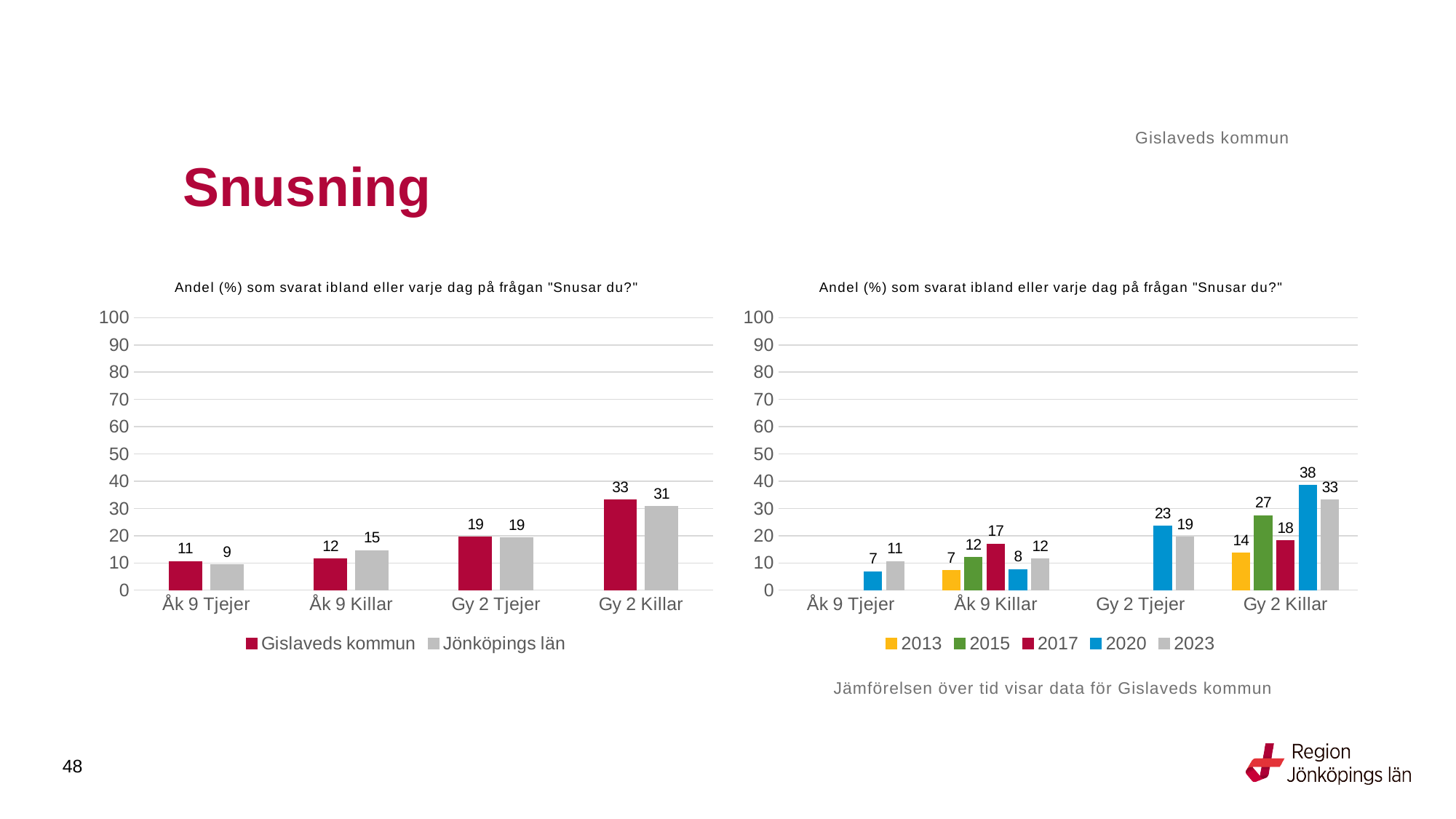
In the right chart, what is the difference between 2020 and 2023 for Gy 2 Tjejer? 4 In the left chart, how many series does the legend list? 2 In the left chart, what is the difference between Gislaveds kommun and Jönköpings län for Gy 2 Killar? 2 In the right chart, what is the value for 2020 for Gy 2 Killar? 38 In the left chart, what is the value for Gislaveds kommun for Gy 2 Killar? 33 In the left chart, which category has the highest value for Gislaveds kommun? Gy 2 Killar In the right chart, what is the value for 2017 for Åk 9 Killar? 17 In the left chart, which is larger for Åk 9 Killar: Gislaveds kommun or Jönköpings län? Jönköpings län In the right chart, which year has the lowest value for Gy 2 Killar? 2013 In the left chart, what is the value for Jönköpings län for Åk 9 Killar? 15 In the right chart, how many series does the legend list? 5 What kind of chart is the right chart? Bar chart